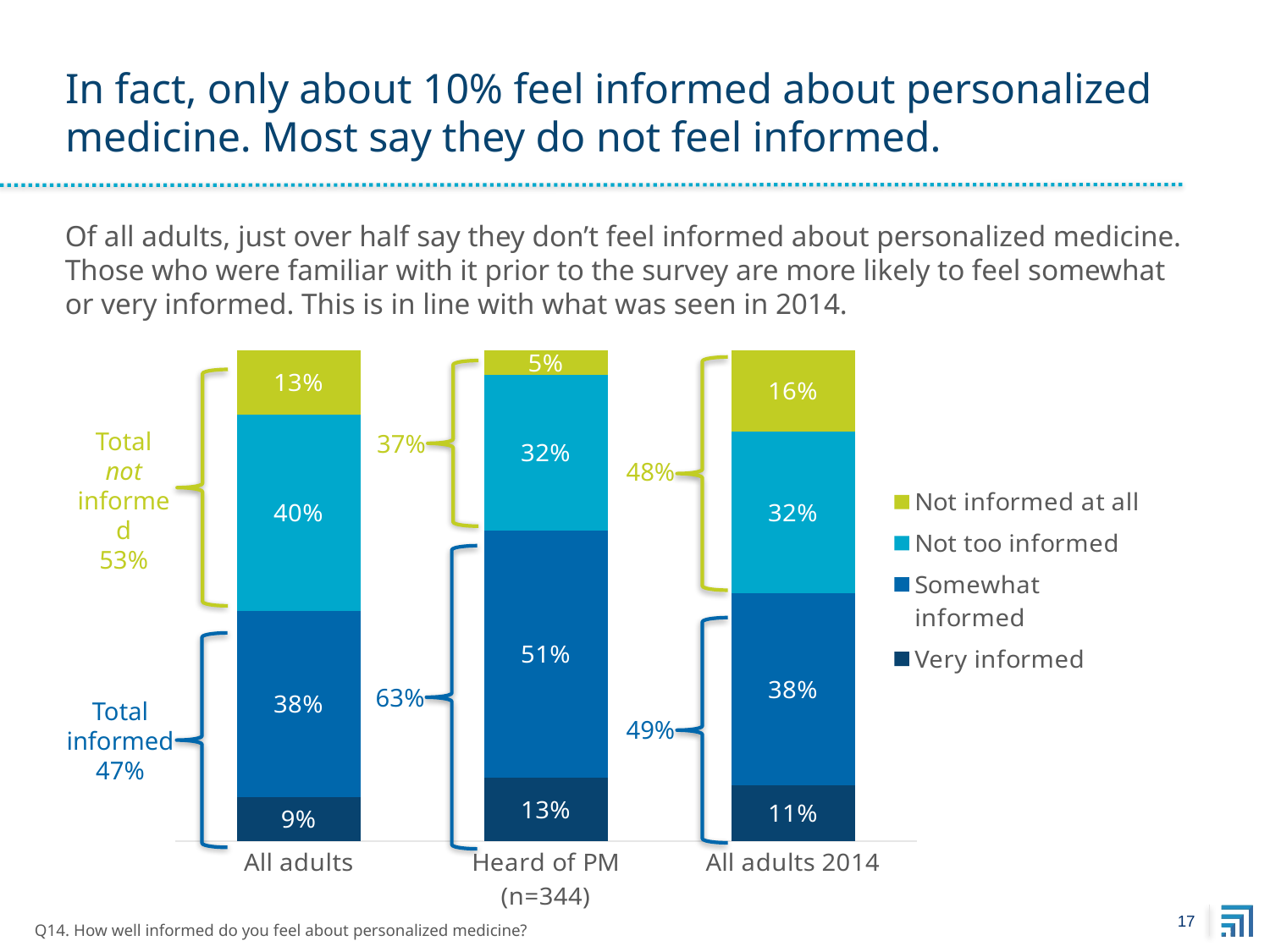
What percentage of all adults are "Very informed" about personalized medicine? 9% Which group has the lowest "Not informed at all" percentage? Heard of PM (n=344) What kind of chart is shown on the slide? Stacked bar chart What is the "Total informed" percentage shown for the "Heard of PM (n=344)" group? 63% What is the "Somewhat informed" value for the "Heard of PM (n=344)" group? 51% Which group has the highest "Somewhat informed" percentage? Heard of PM (n=344) Is the "Very informed" value larger for "Heard of PM (n=344)" or for "All adults 2014"? Heard of PM (n=344) How many series does the legend list? 4 Which legend entry is shown in the lightest green colour? Not informed at all What is the "Not informed at all" value for "All adults 2014"? 16% What is the difference between the "Not too informed" value for "All adults" and for "Heard of PM (n=344)"? 8 percentage points How many groups (bars) are shown on the x axis? 3